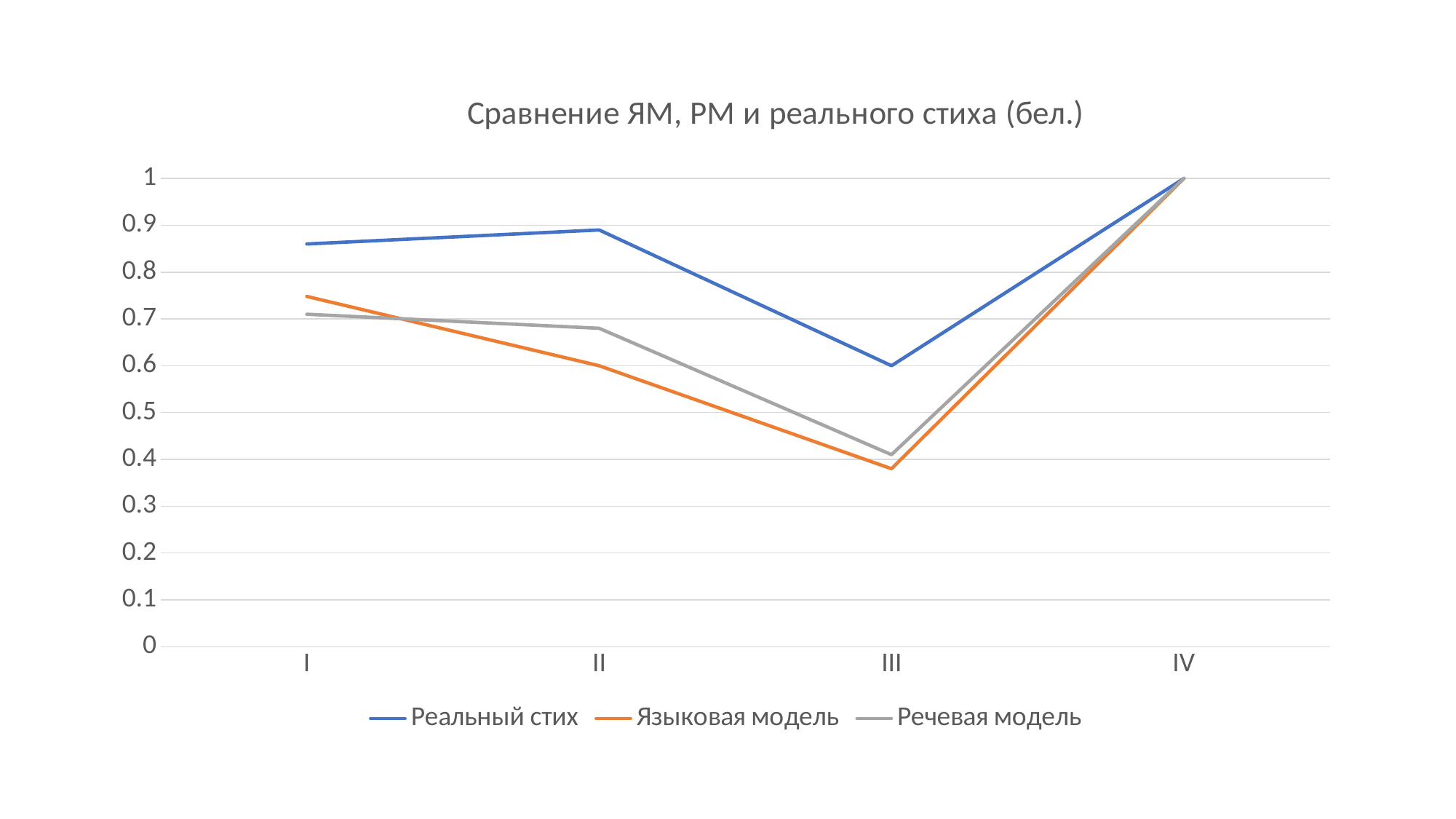
Is the value for Реальный стих at category I greater or less than 0.8? greater How many categories are on the x axis? 4 At category I, which is larger: Реальный стих or Языковая модель? Реальный стих Is the value for Языковая модель at category III greater or less than 0.4? less How many series does the legend list? 3 What is the title of the chart? Сравнение ЯМ, РМ и реального стиха (бел.) What is the value for Реальный стих at category IV? 1 What kind of chart is shown on the slide? line chart At which category does Языковая модель have its lowest value? III Is the value for Речевая модель at category I greater or less than 0.8? less What is the value for Языковая модель at category IV? 1 At which category does Речевая модель have its highest value? IV